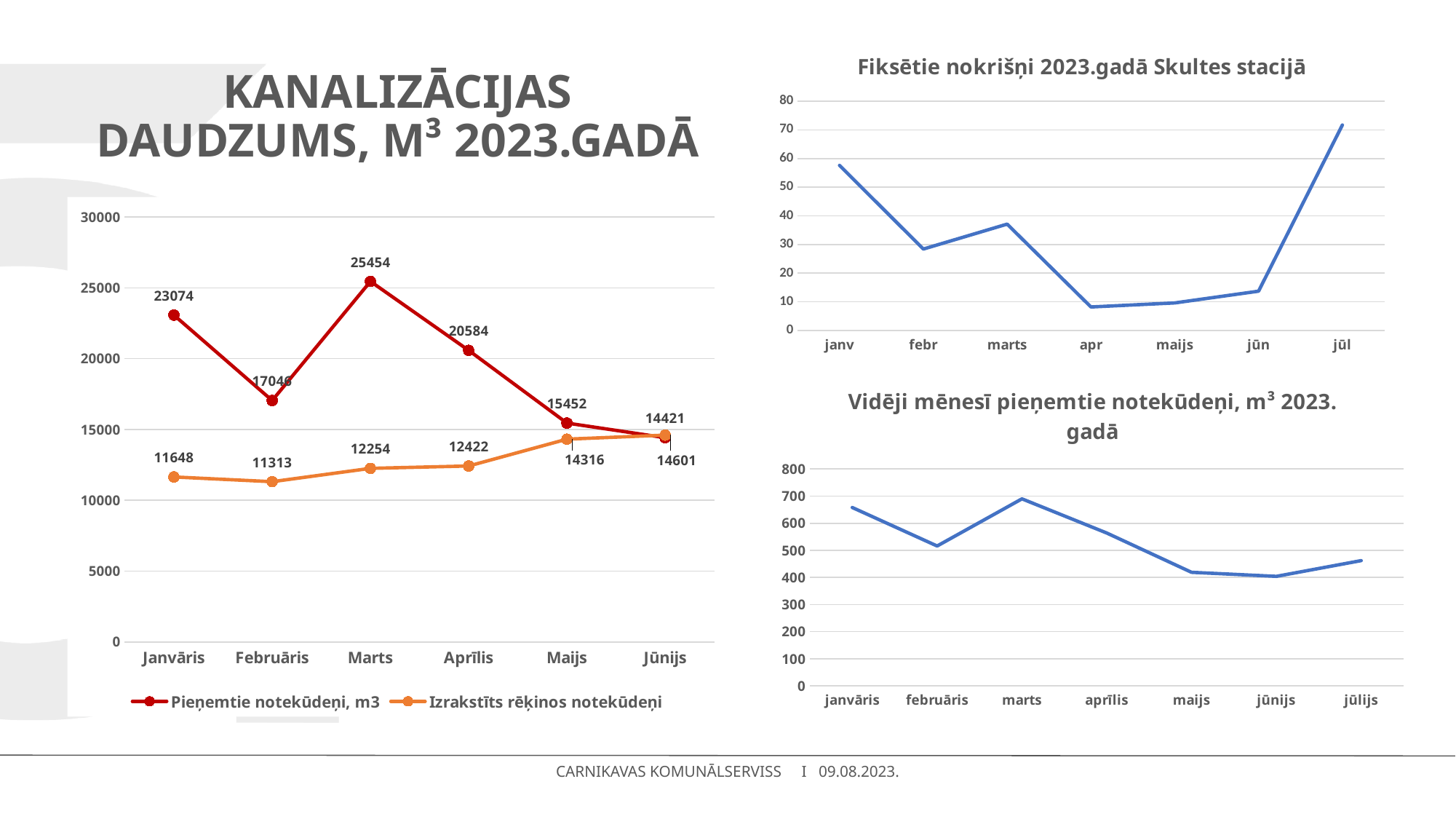
In the chart titled 'KANALIZĀCIJAS DAUDZUMS, M³ 2023.GADĀ', what is the value of 'Izrakstīts rēķinos notekūdeņi' for Aprīlis? 12422 In the chart titled 'KANALIZĀCIJAS DAUDZUMS, M³ 2023.GADĀ', what is the value of 'Pieņemtie notekūdeņi, m3' for Marts? 25454 What kind of chart is 'Fiksētie nokrišņi 2023.gadā Skultes stacijā'? Line chart In the chart titled 'Fiksētie nokrišņi 2023.gadā Skultes stacijā', is the value for apr greater or less than 10? less How many series does the legend of the chart titled 'KANALIZĀCIJAS DAUDZUMS, M³ 2023.GADĀ' list? 2 In the chart titled 'KANALIZĀCIJAS DAUDZUMS, M³ 2023.GADĀ', what is the difference between 'Pieņemtie notekūdeņi, m3' and 'Izrakstīts rēķinos notekūdeņi' in Janvāris? 11426 In the chart titled 'Fiksētie nokrišņi 2023.gadā Skultes stacijā', which month has the highest value? jūl In the chart titled 'KANALIZĀCIJAS DAUDZUMS, M³ 2023.GADĀ', in which month is 'Izrakstīts rēķinos notekūdeņi' lowest? Februāris In the chart titled 'KANALIZĀCIJAS DAUDZUMS, M³ 2023.GADĀ', which is larger in Maijs: 'Pieņemtie notekūdeņi, m3' or 'Izrakstīts rēķinos notekūdeņi'? Pieņemtie notekūdeņi, m3 In the chart titled 'KANALIZĀCIJAS DAUDZUMS, M³ 2023.GADĀ', in which month is 'Pieņemtie notekūdeņi, m3' highest? Marts How many months are shown on the x axis of the chart titled 'Vidēji mēnesī pieņemtie notekūdeņi, m³ 2023. gadā'? 7 In the chart titled 'Vidēji mēnesī pieņemtie notekūdeņi, m³ 2023. gadā', is the value for jūnijs greater or less than 500? less